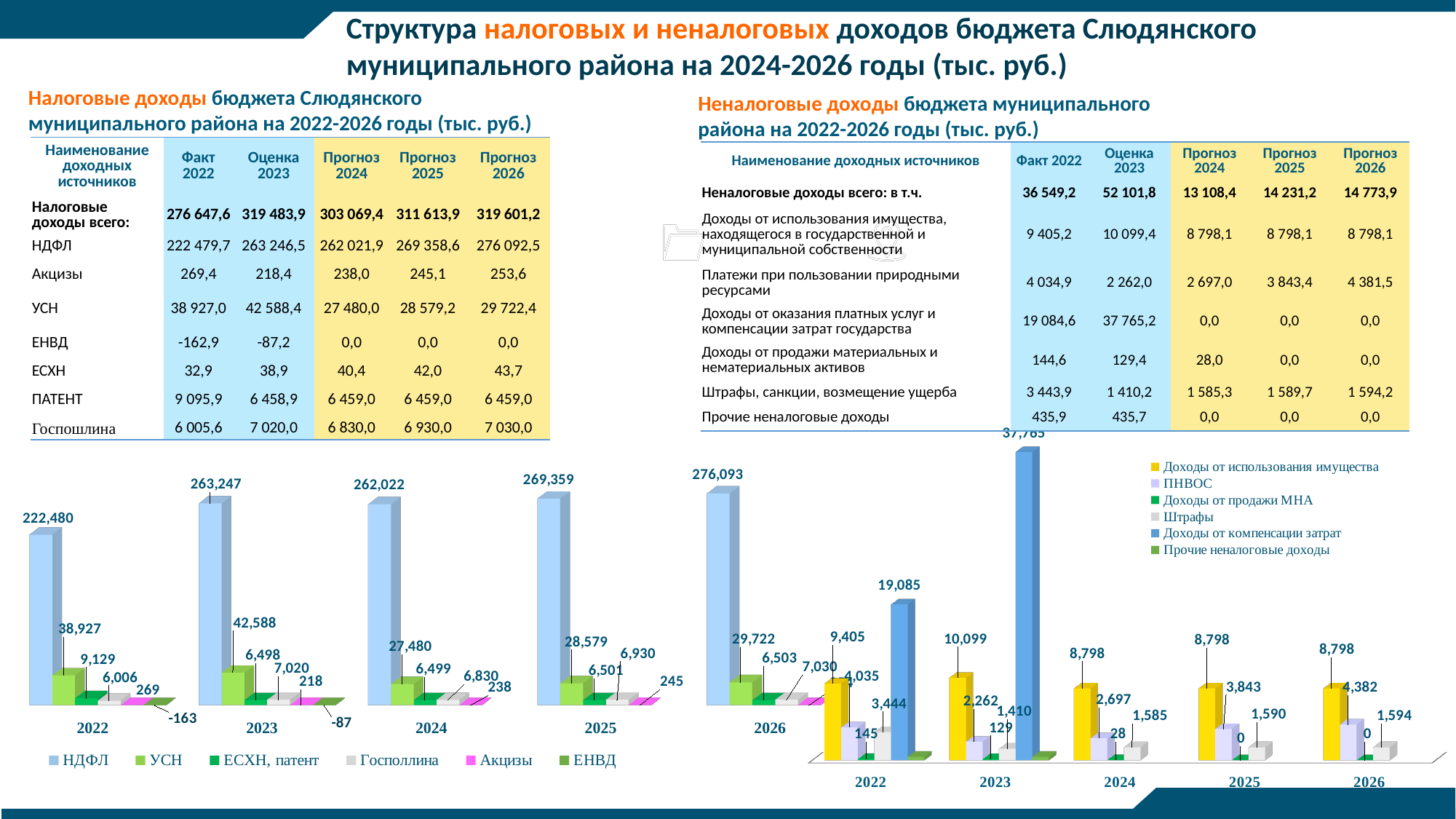
In the right chart (non-tax revenues), how many years are shown on the x axis? 5 In the left chart (tax revenues), what is the value of ЕНВД for 2022? -163 In the right chart (non-tax revenues), in which year is ПНВОС lowest? 2023 In the right chart (non-tax revenues), what is the value of Доходы от компенсации затрат for 2023? 37,765 In the right chart (non-tax revenues), what is the value of Штрафы for 2024? 1,585 What type of chart is the right chart (non-tax revenues)? Bar chart In the left chart (tax revenues), in which year is НДФЛ highest? 2026 In the left chart (tax revenues), what is the value of УСН for 2023? 42,588 In the left chart (tax revenues), which is larger: УСН in 2022 or УСН in 2024? УСН in 2022 In the left chart (tax revenues), how many series does the legend list? 6 In the left chart (tax revenues), what is the difference between НДФЛ in 2026 and НДФЛ in 2022? 53,613 In the left chart (tax revenues), what is the value of НДФЛ for 2022? 222,480